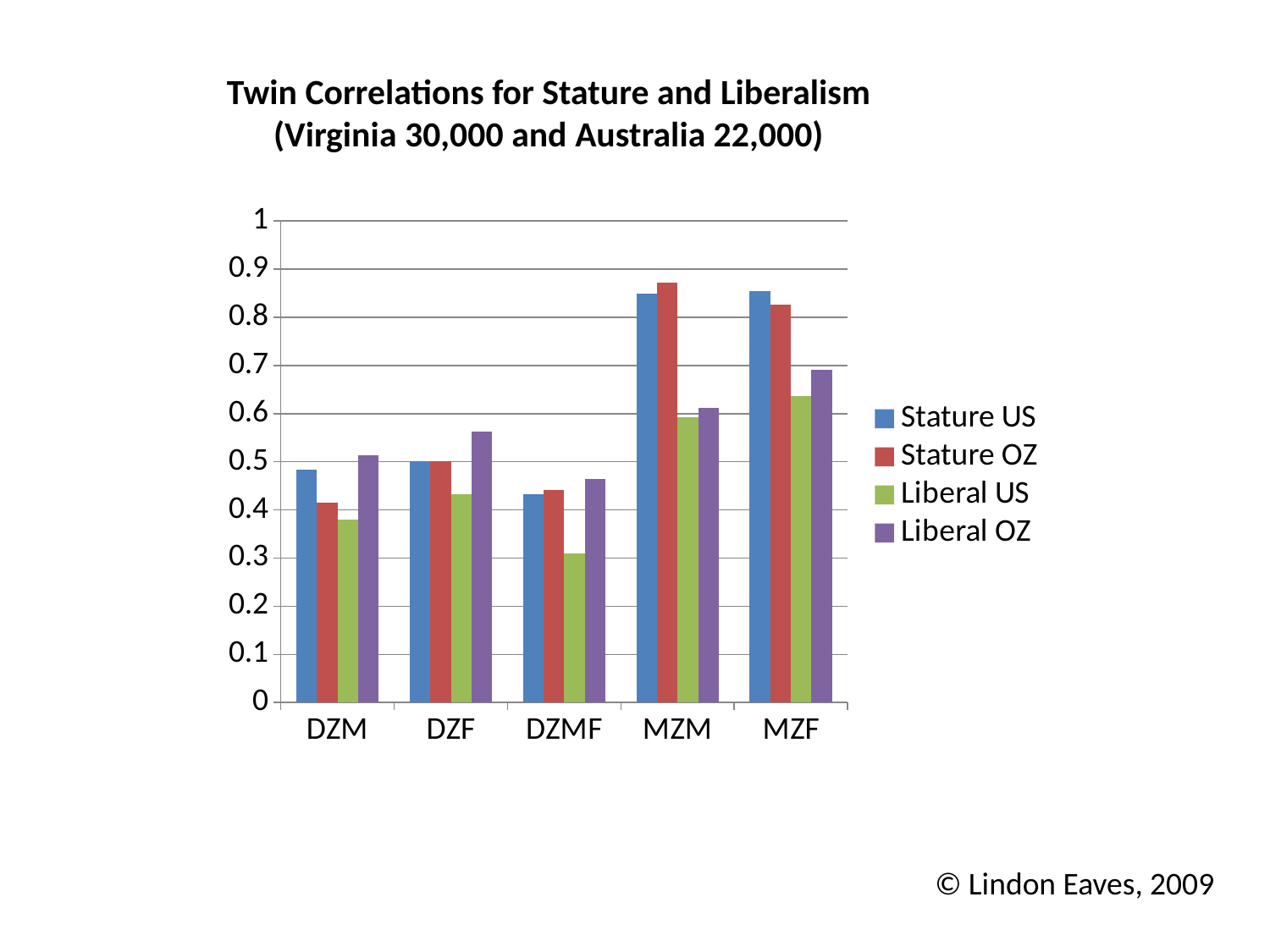
For MZF, which is larger: Liberal OZ or Liberal US? Liberal OZ What kind of chart is shown on the slide? bar chart What colour represents the Liberal US series in the legend? green Which category has the highest Stature OZ value? MZM Is the Liberal US value for DZMF greater or less than 0.4? less How many categories are shown on the x axis? 5 Which category has the lowest Liberal US value? DZMF How many series does the legend list? 4 For DZM, which is larger: Stature US or Liberal US? Stature US Which category has the highest Liberal OZ value? MZF Is the Liberal OZ value for DZF greater or less than 0.5? greater Is the Stature OZ value for MZM greater or less than 0.8? greater